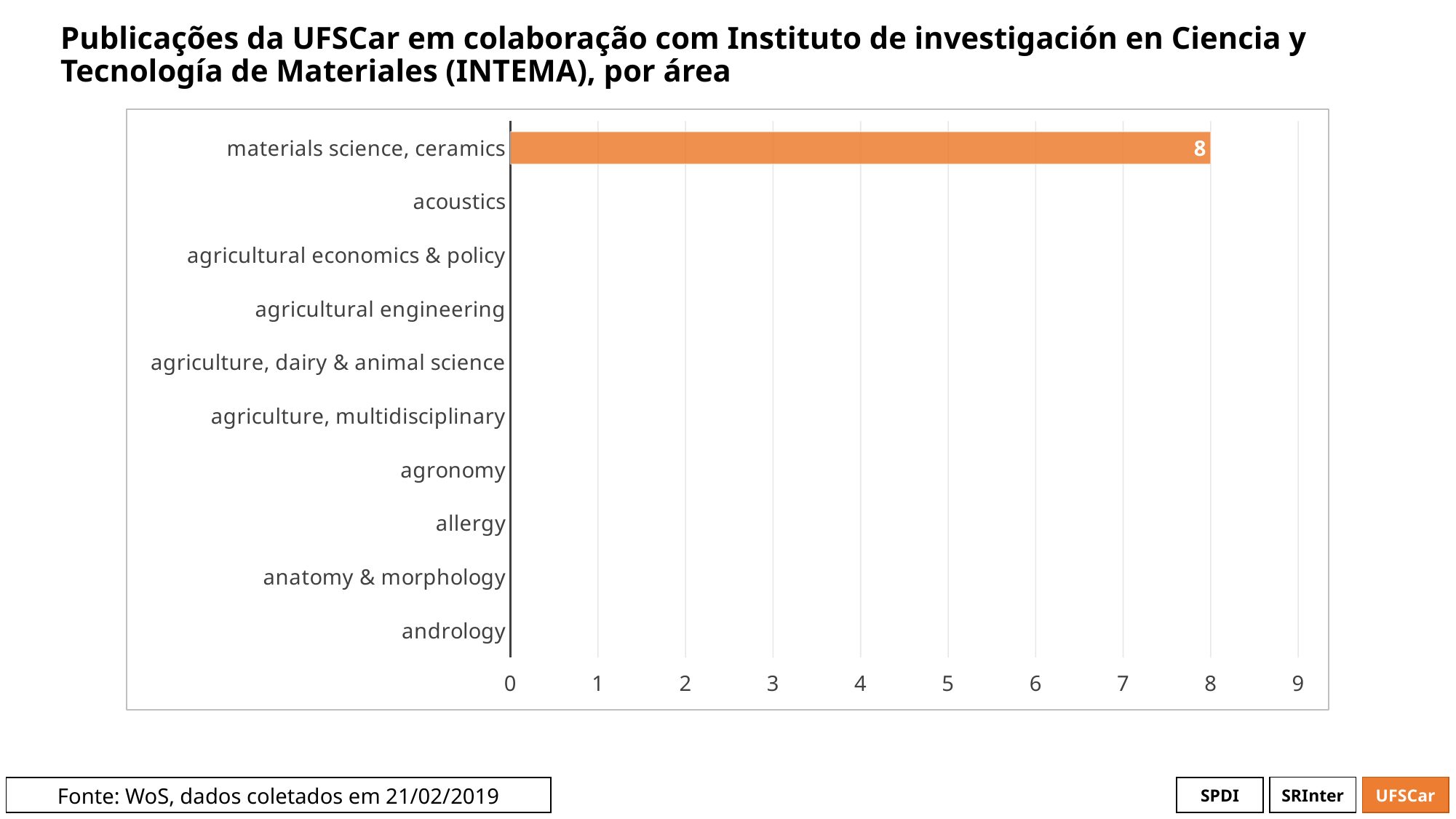
Which is larger, the value for materials science, ceramics or the value for acoustics? materials science, ceramics How many categories are listed on the y axis? 10 Is the value for materials science, ceramics greater or less than 5? greater What is the highest tick value shown on the x axis? 9 What is the value for materials science, ceramics? 8 Which category is listed last (at the bottom) on the y axis? andrology What kind of chart is shown on the slide? bar chart Which category has the highest value? materials science, ceramics